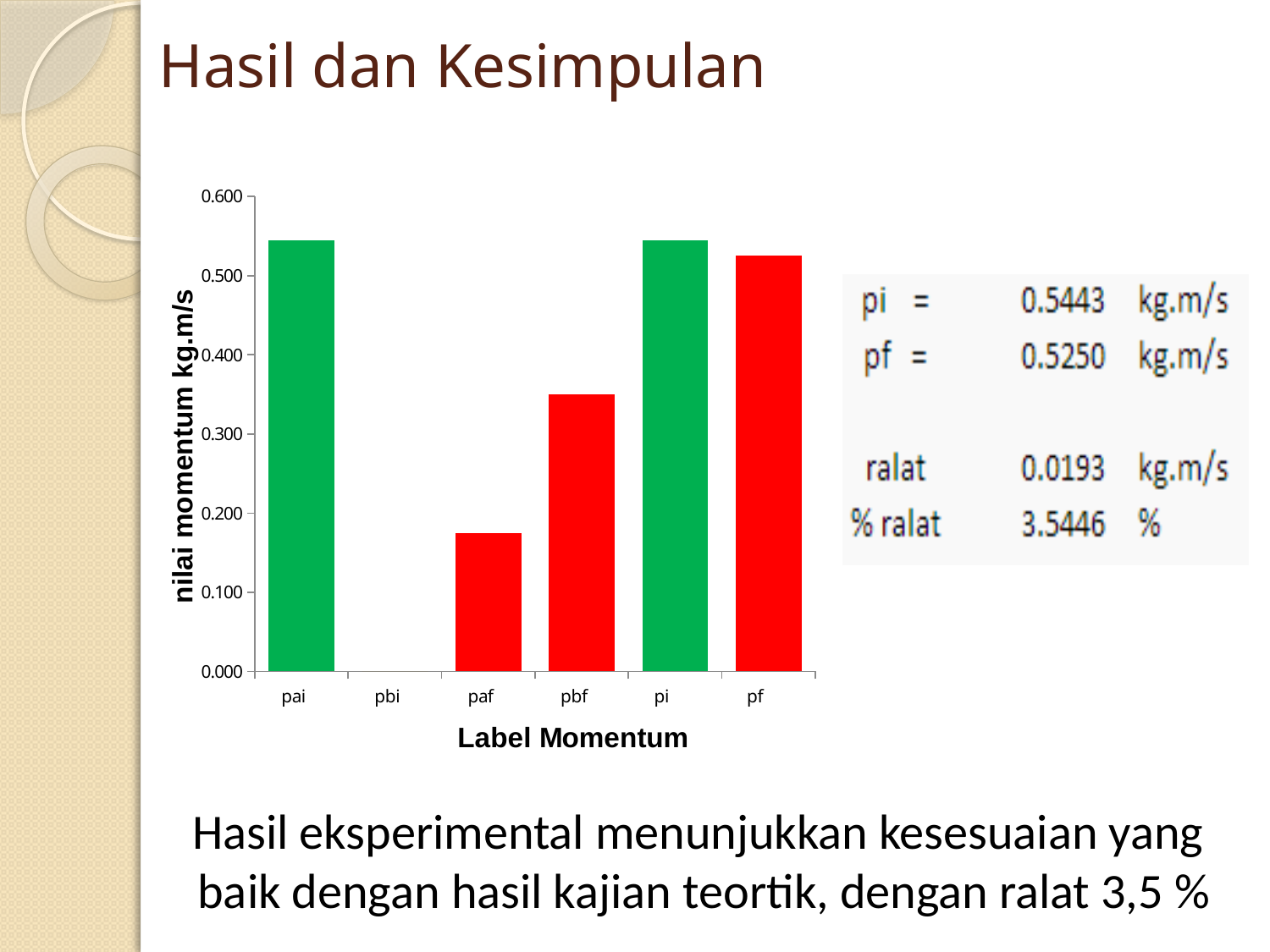
What is the title of the x axis of the chart? Label Momentum What kind of chart is shown on the slide? bar chart Is the value for pbf greater or less than 0.300? greater Which has the larger value, pai or paf? pai Which of the red bars is the shortest? paf Is the value for pai greater or less than 0.500? greater Which has the larger value, paf or pbf? pbf Is the value for paf greater or less than 0.200? less How many categories are shown on the x axis of the chart? 6 What is the title of the y axis of the chart? nilai momentum kg.m/s